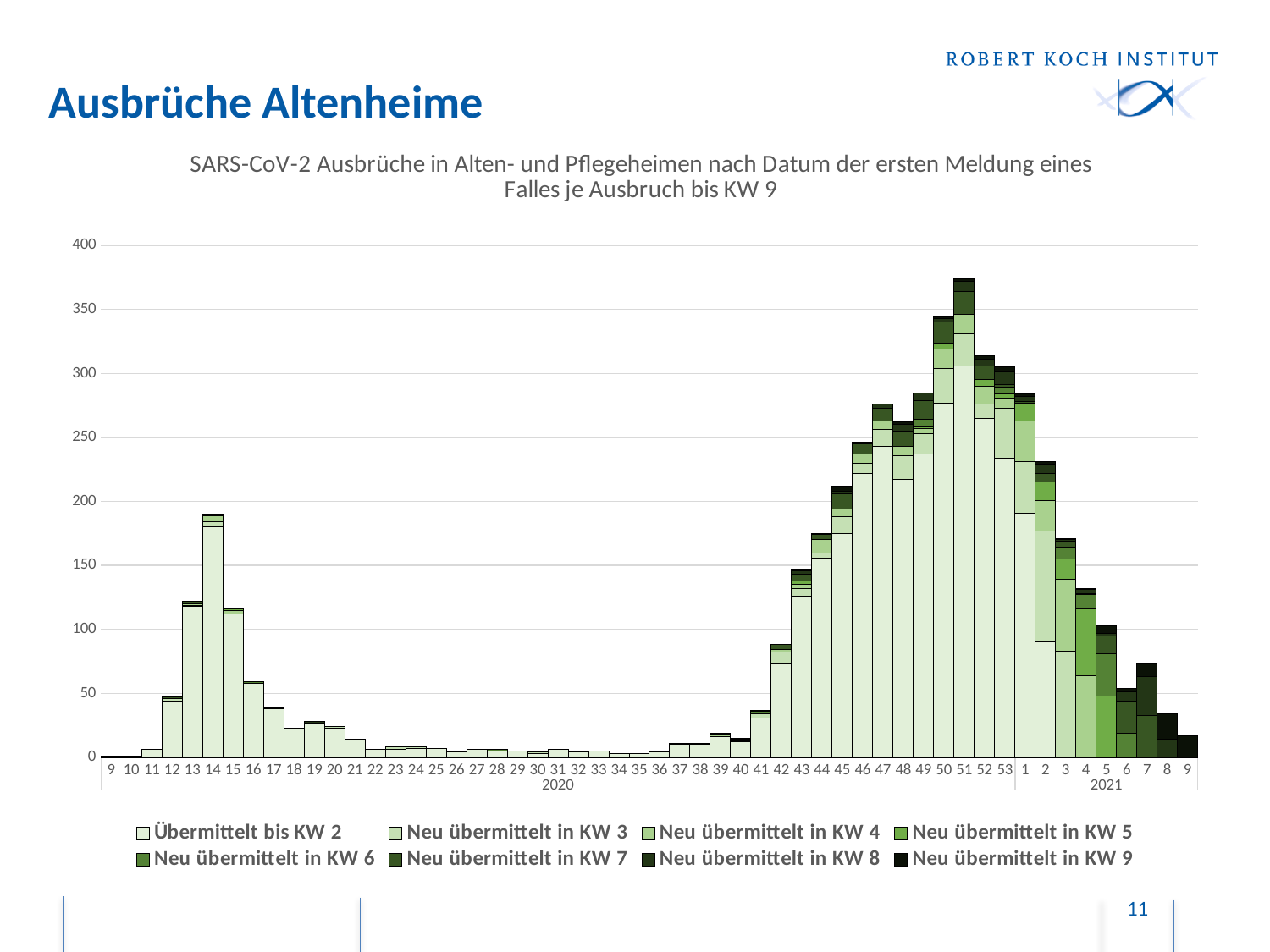
What is the first entry in the chart's legend? Übermittelt bis KW 2 Which calendar week has the highest total number of outbreaks? KW 51 2020 Is the total for KW 30 2020 greater or less than 50? less Is the total for KW 9 2021 greater or less than 50? less What is the title of the chart? SARS-CoV-2 Ausbrüche in Alten- und Pflegeheimen nach Datum der ersten Meldung eines Falles je Ausbruch bis KW 9 Is the total for KW 14 2020 greater or less than 150? greater How many series does the legend list? 8 Which has a larger total, KW 14 2020 or KW 15 2020? KW 14 2020 Do the totals rise or fall from KW 1 2021 to KW 9 2021? fall What kind of chart is shown on the slide? Stacked bar chart Which has a larger total, KW 14 2020 or KW 47 2020? KW 47 2020